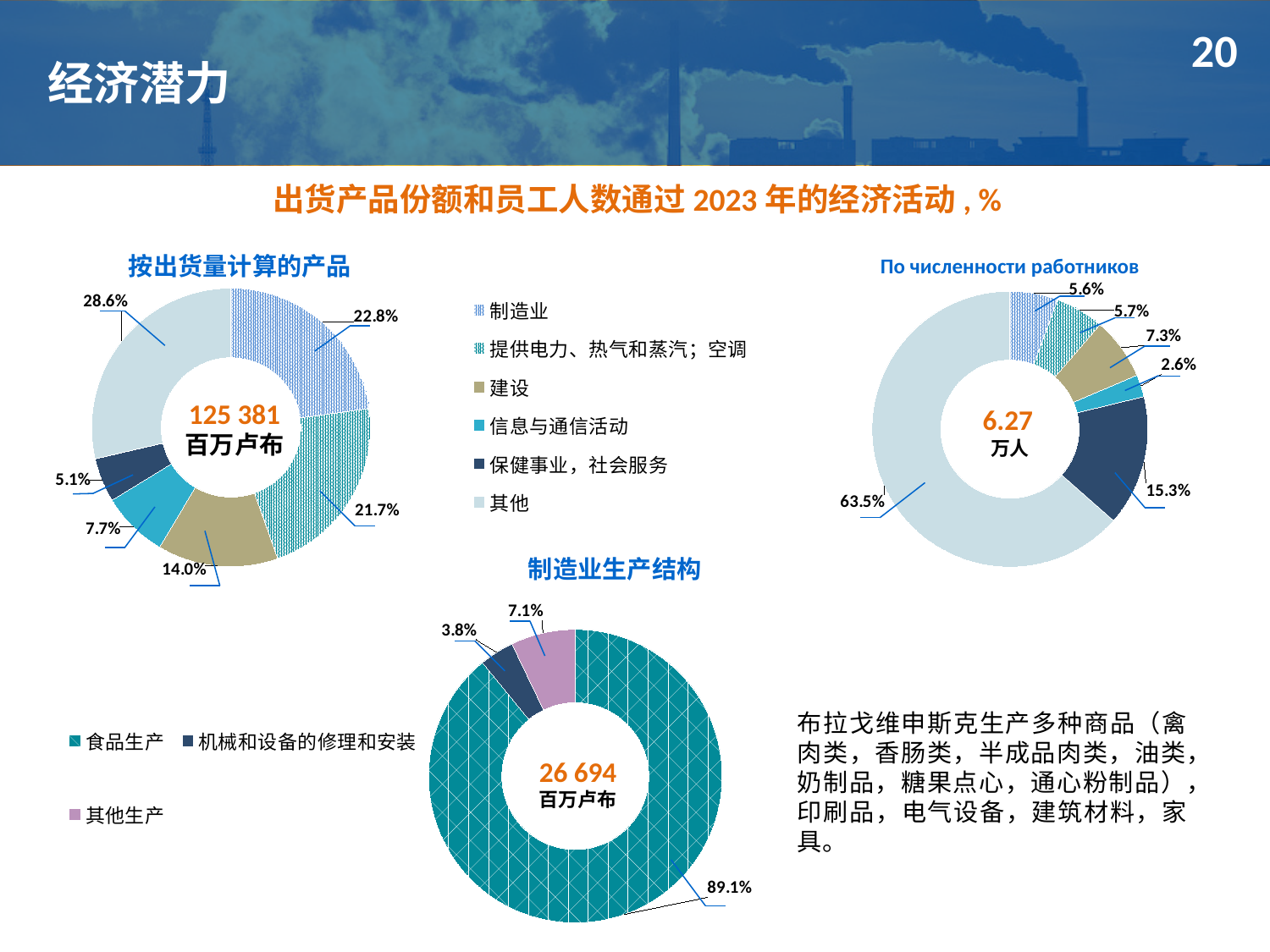
How many categories does the legend of the chart titled 制造业生产结构 list? 3 In the chart titled 制造业生产结构, which is larger: 机械和设备的修理和安装 or 其他生产? 其他生产 In the chart titled По численности работников, which category has the smallest share? 信息与通信活动 In the chart titled 按出货量计算的产品, what total value is shown in the centre of the donut? 125 381 百万卢布 In the chart titled По численности работников, what share does 其他 have? 63.5% In the chart titled 按出货量计算的产品, what share does 制造业 have? 22.8% In the chart titled 按出货量计算的产品, what share does 建设 have? 14.0% In the chart titled 按出货量计算的产品, which category has the largest share? 其他 In the chart titled По численности работников, what share does 保健事业，社会服务 have? 15.3% In the chart titled 制造业生产结构, what share does 食品生产 have? 89.1% In the chart titled 按出货量计算的产品, which category has the smallest share? 保健事业，社会服务 In the chart titled 按出货量计算的产品, what is the difference between the shares of 制造业 and 提供电力、热气和蒸汽；空调? 1.1%